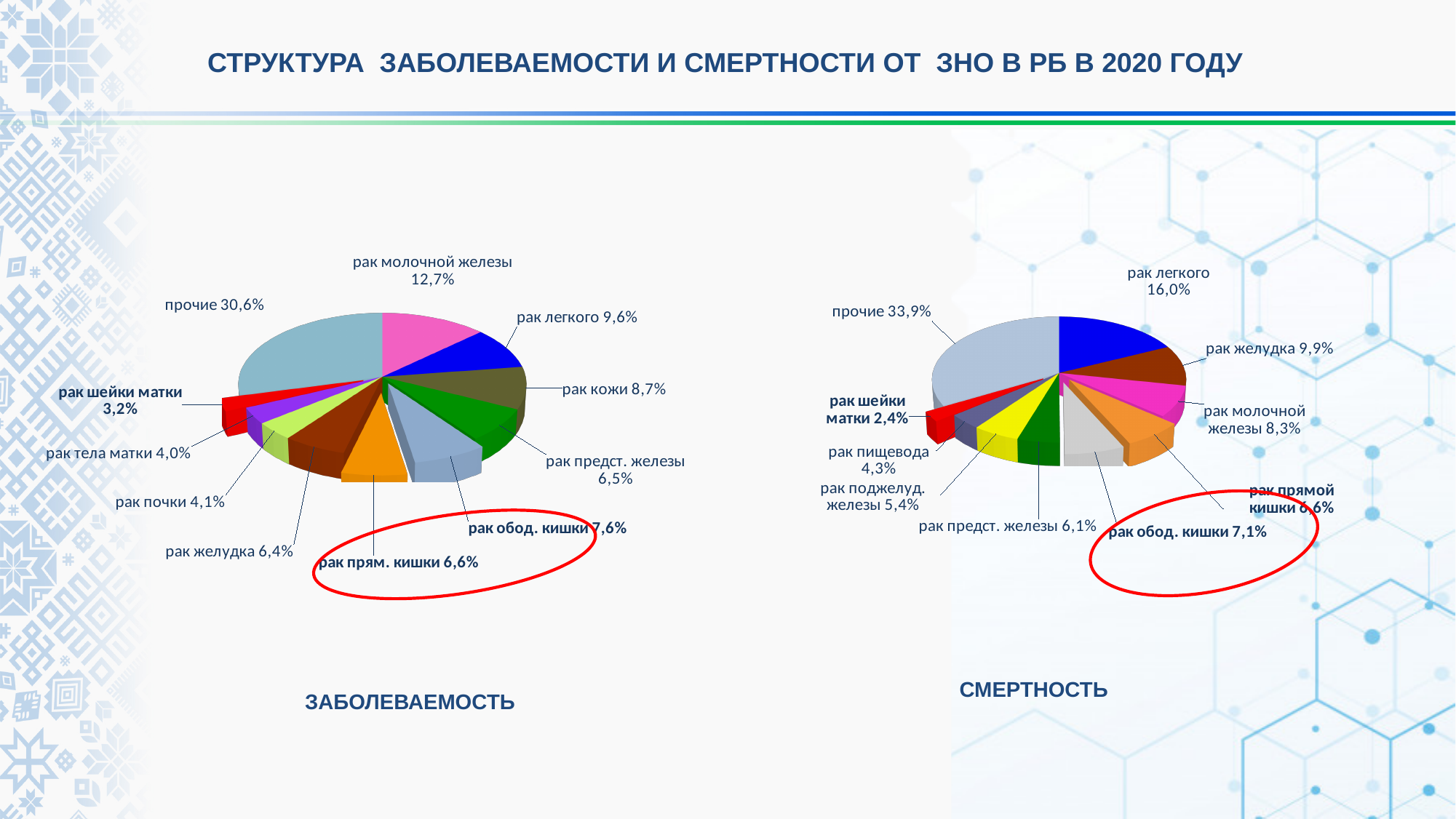
In the СМЕРТНОСТЬ pie chart, what share is shown for рак поджелуд. железы? 5,4% In the ЗАБОЛЕВАЕМОСТЬ pie chart, which is larger: the share of рак легкого or the share of рак кожи? рак легкого In the ЗАБОЛЕВАЕМОСТЬ pie chart, what share is shown for рак молочной железы? 12,7% In the ЗАБОЛЕВАЕМОСТЬ pie chart, what share is shown for рак обод. кишки? 7,6% In the ЗАБОЛЕВАЕМОСТЬ pie chart, which category has the smallest share? рак шейки матки In the ЗАБОЛЕВАЕМОСТЬ pie chart, which named cancer type (excluding прочие) has the largest share? рак молочной железы In the СМЕРТНОСТЬ pie chart, which category has the smallest share? рак шейки матки What type of chart is used for ЗАБОЛЕВАЕМОСТЬ? Pie chart How many slices does the ЗАБОЛЕВАЕМОСТЬ pie chart have? 11 In the СМЕРТНОСТЬ pie chart, what share is shown for рак легкого? 16,0% In the СМЕРТНОСТЬ pie chart, what is the difference between the shares of рак легкого and рак желудка? 6,1% How many slices does the СМЕРТНОСТЬ pie chart have? 10